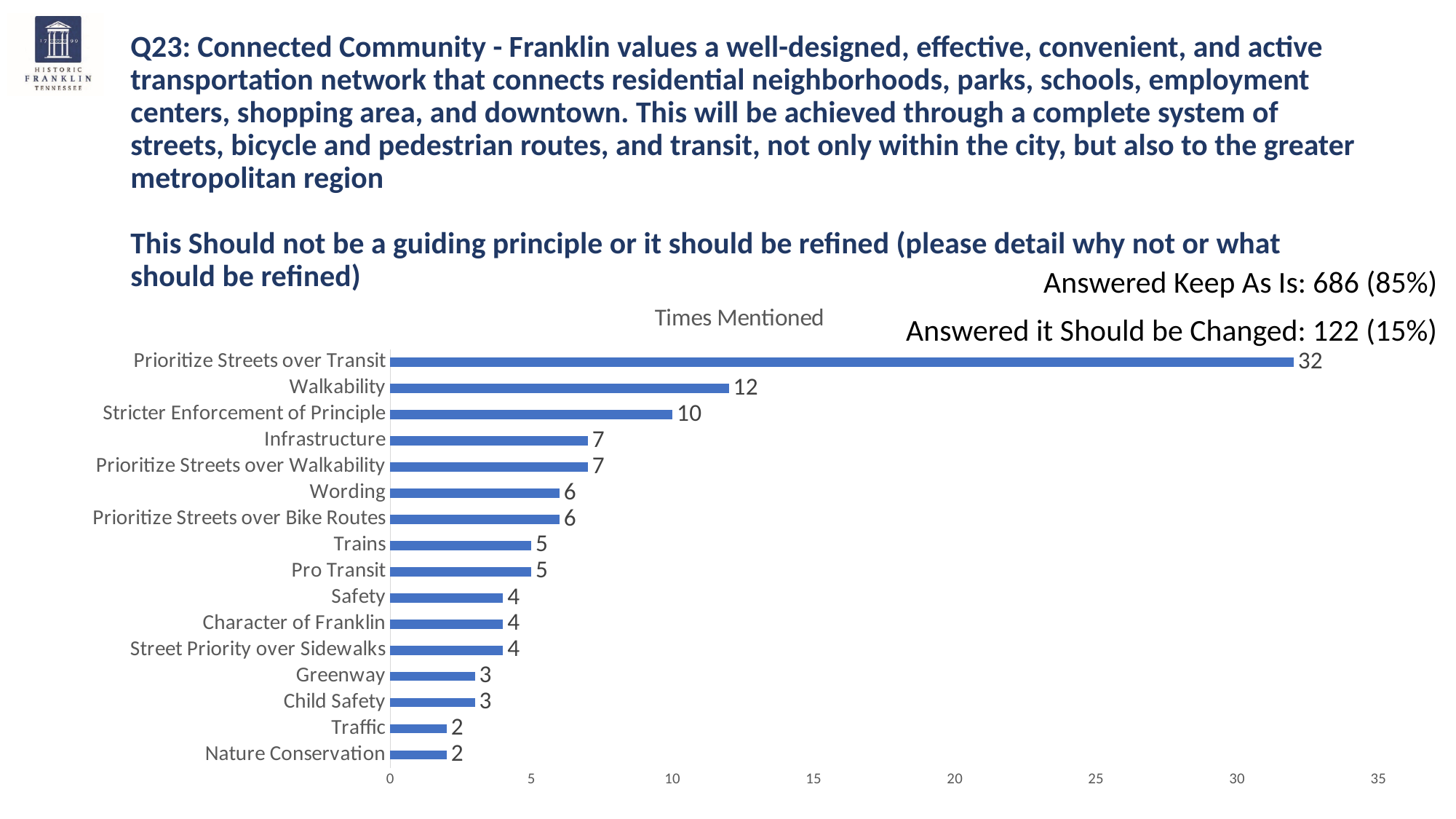
Is the value for "Prioritize Streets over Transit" greater or less than 30? greater Which category has the highest number of times mentioned? Prioritize Streets over Transit What kind of chart is shown on the slide? bar chart How many times was "Prioritize Streets over Transit" mentioned? 32 How many categories are shown in the chart? 16 How many times was "Stricter Enforcement of Principle" mentioned? 10 What is the difference between the values for "Prioritize Streets over Transit" and "Walkability"? 20 What is the title of the chart? Times Mentioned What is the difference between the values for "Wording" and "Traffic"? 4 What is the value for "Walkability"? 12 What is the value for "Greenway"? 3 Which is larger, the value for "Infrastructure" or the value for "Trains"? Infrastructure